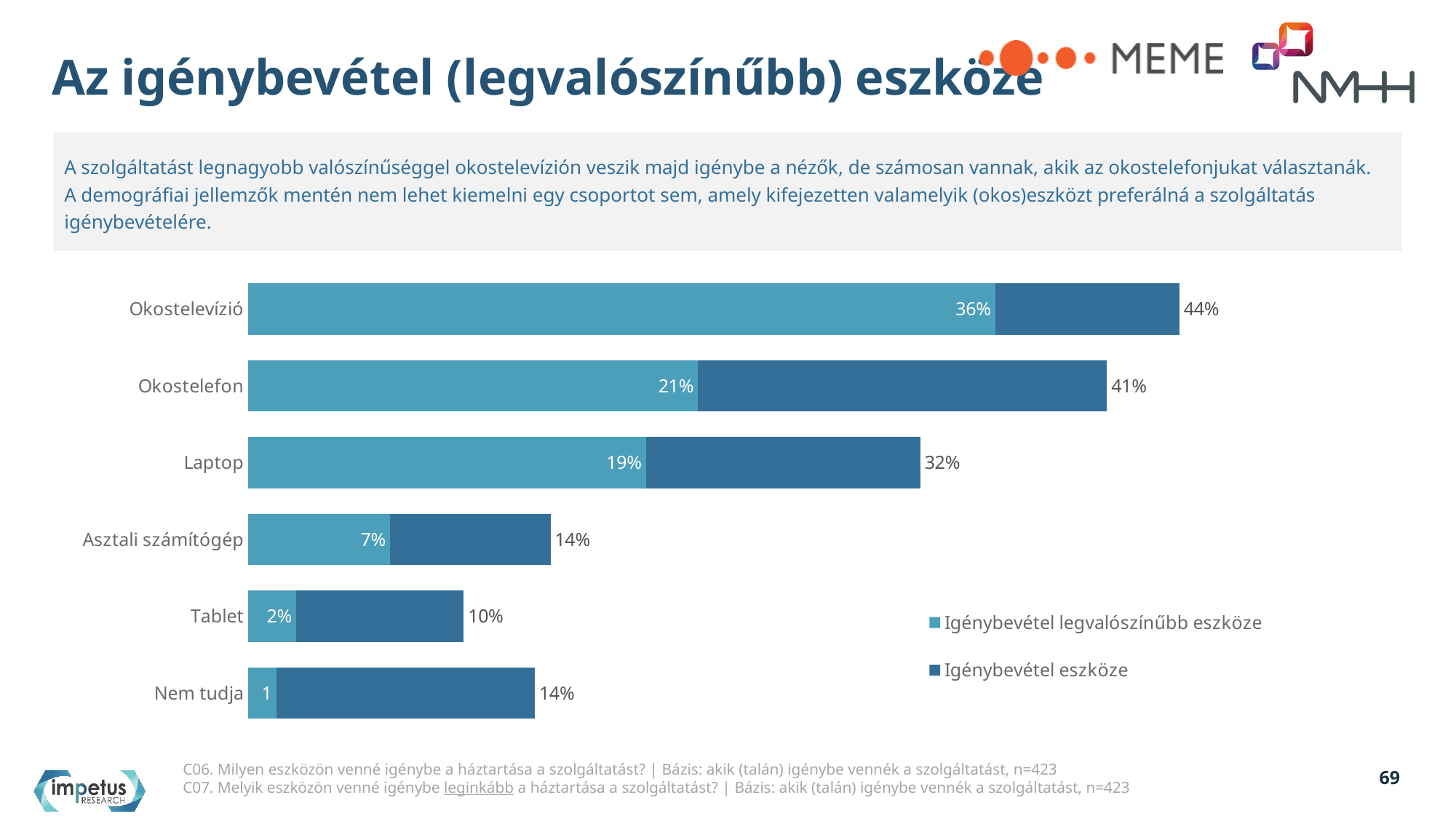
What is the value of 'Igénybevétel eszköze' for Okostelefon? 41% How many series does the legend list? 2 What is the value of 'Igénybevétel eszköze' for Tablet? 10% Which series is shown in the darker blue colour? Igénybevétel eszköze How many categories are shown on the chart? 6 Which category has the lowest value for 'Igénybevétel legvalószínűbb eszköze'? Nem tudja What kind of chart is shown on the slide? bar chart Which is larger: the 'Igénybevétel legvalószínűbb eszköze' value for Okostelefon or for Asztali számítógép? Okostelefon Which category has the highest value for 'Igénybevétel eszköze'? Okostelevízió What is the value of 'Igénybevétel legvalószínűbb eszköze' for Okostelevízió? 36% What is the value of 'Igénybevétel legvalószínűbb eszköze' for Laptop? 19% What is the difference between the 'Igénybevétel eszköze' values for Okostelevízió and Laptop? 12%